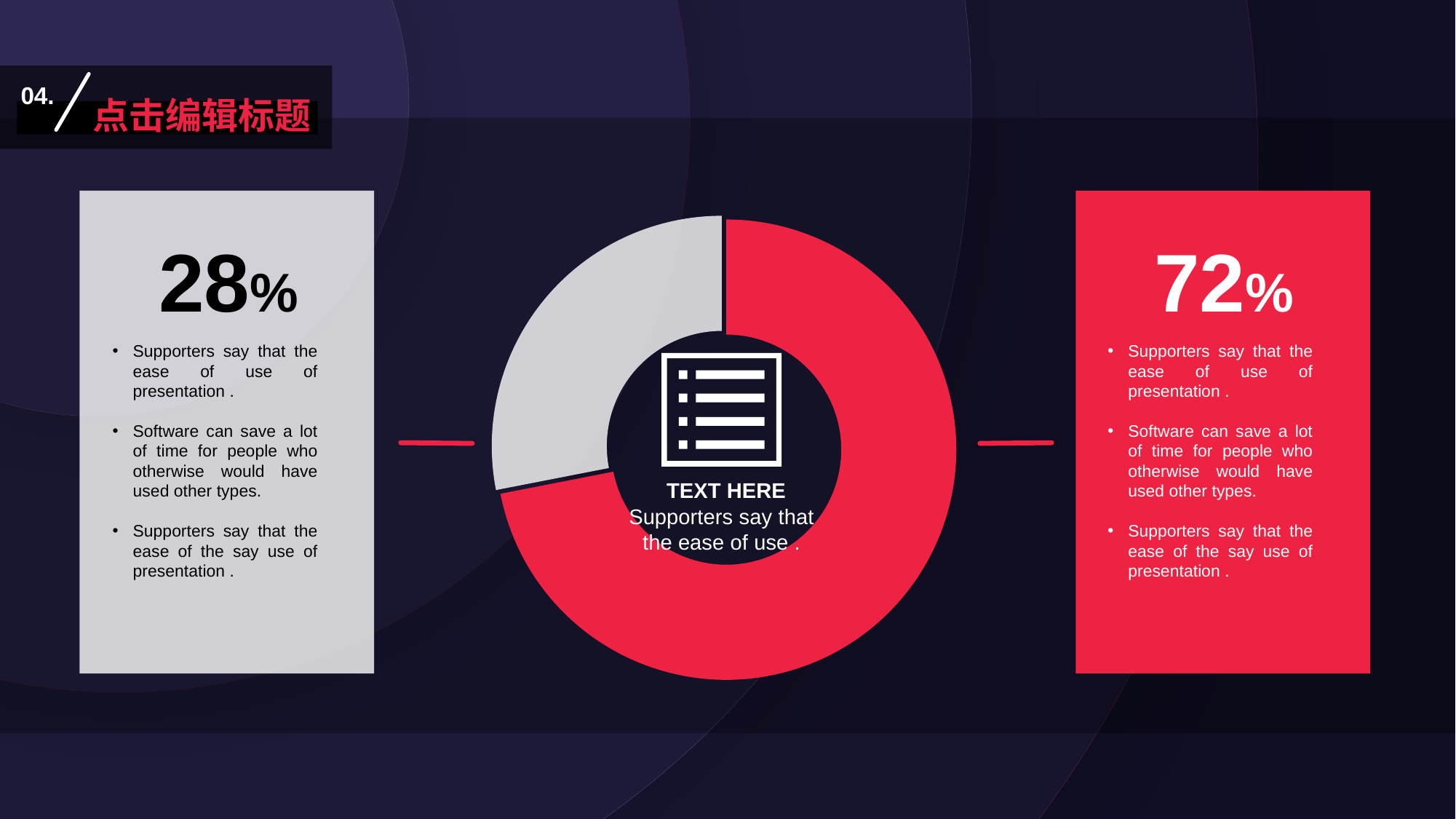
What do the two slices of the donut chart add up to? 100% What is the difference between the red slice's share and the grey slice's share? 44 percentage points What colour is the slice that represents 28%? grey What percentage does the grey slice of the donut chart represent? 28% Is the red slice larger or smaller than the grey slice? larger What heading text is printed in the centre of the donut chart? TEXT HERE How many slices does the donut chart have? 2 What kind of chart is shown in the centre of the slide? donut (pie) chart Which slice of the donut chart is the smallest? the grey slice (28%) Which slice of the donut chart is the largest? the red slice (72%) What percentage does the red slice of the donut chart represent? 72% Is the red slice's share greater or less than 50%? greater